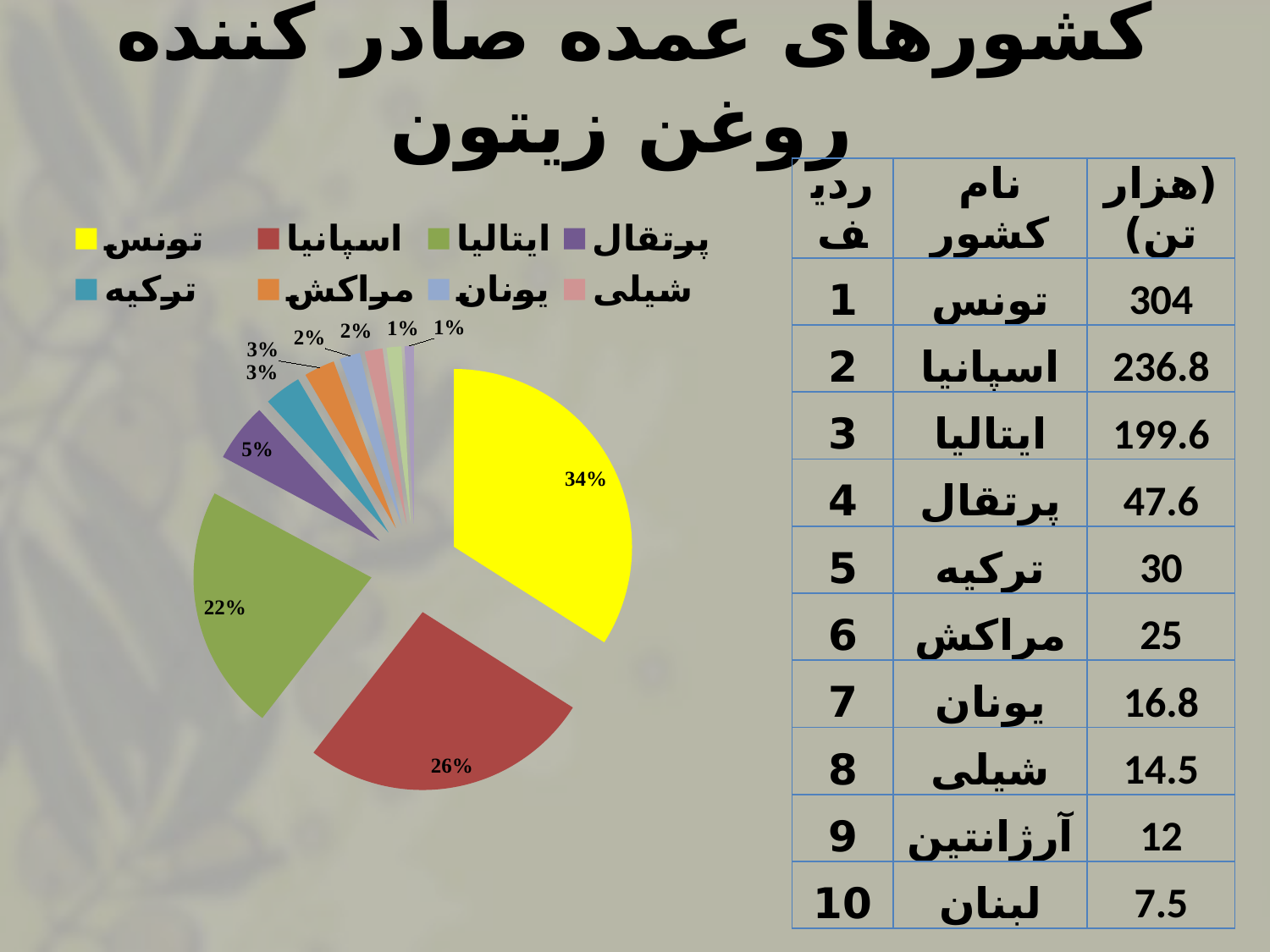
What kind of chart is shown on the slide? pie chart Which slice is larger, اسپانیا (Spain) or ایتالیا (Italy)? اسپانیا (Spain) How many slices does the pie chart have? 10 How many entries does the chart legend list? 8 What percentage is shown for the اسپانیا (Spain) slice? 26% What percentage is shown for the پرتقال (Portugal) slice? 5% What percentage is shown for the ایتالیا (Italy) slice? 22% What colour is the تونس (Tunisia) slice? yellow What is the difference in percentage points between the تونس (Tunisia) slice and the اسپانیا (Spain) slice? 8 percentage points What share of the pie does تونس (Tunisia) hold? 34% Which country has the largest slice of the pie? تونس (Tunisia) Which country is represented by the green slice? ایتالیا (Italy)